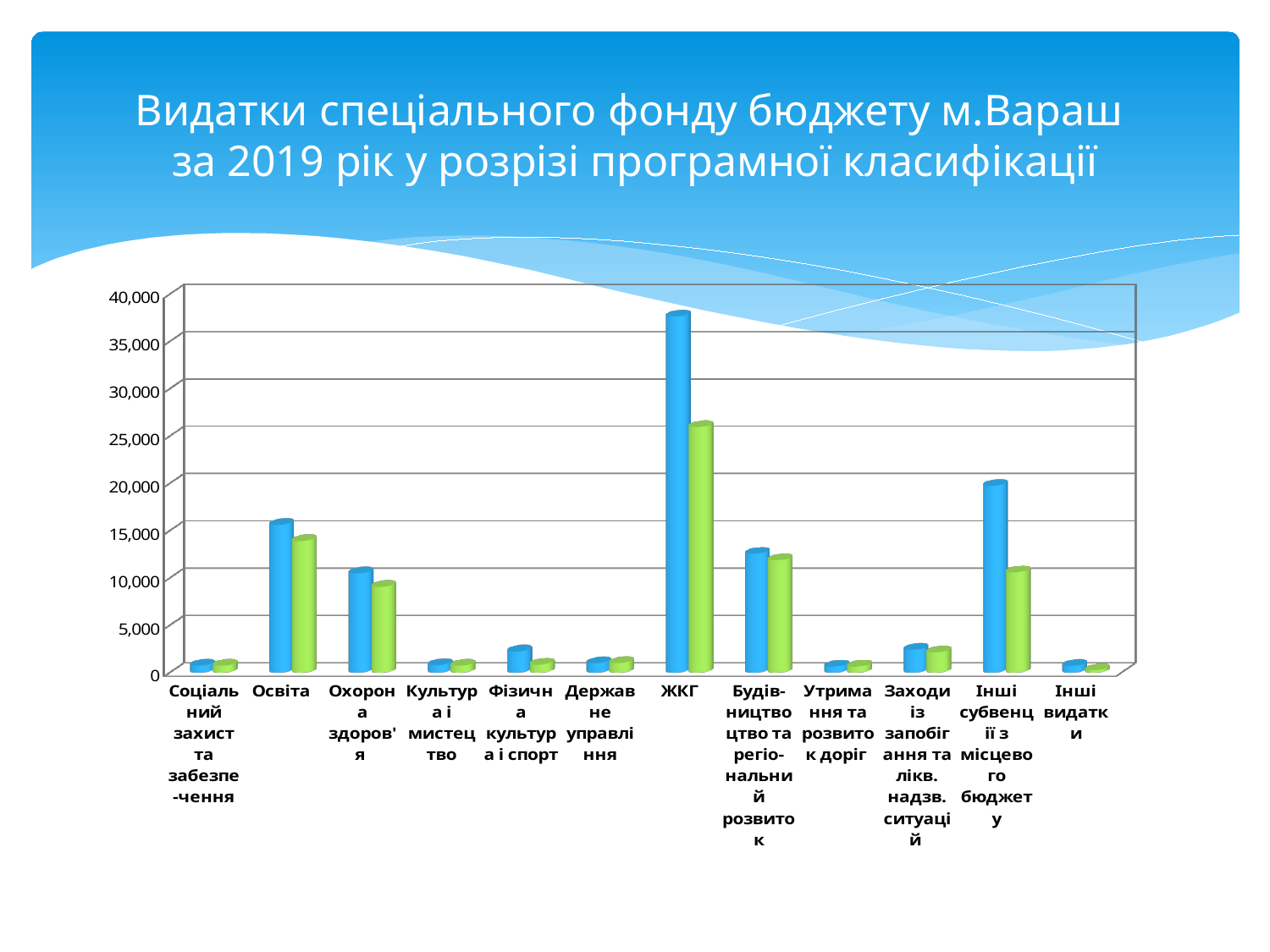
Which category has the highest blue bar in the chart? ЖКГ Is the green bar for ЖКГ greater or less than 20,000? greater What kind of chart is shown on the slide? bar chart Which has the larger blue bar: Інші субвенції з місцевого бюджету or Будівництво та регіональний розвиток? Інші субвенції з місцевого бюджету Which has the larger blue bar: ЖКГ or Освіта? ЖКГ Which category has the highest green bar in the chart? ЖКГ Is the blue bar for Будівництво та регіональний розвиток greater or less than 10,000? greater Is the blue bar for Освіта greater or less than 10,000? greater How many categories are shown along the x axis of the chart? 12 What is the title of the slide containing the chart? Видатки спеціального фонду бюджету м.Вараш за 2019 рік у розрізі програмної класифікації